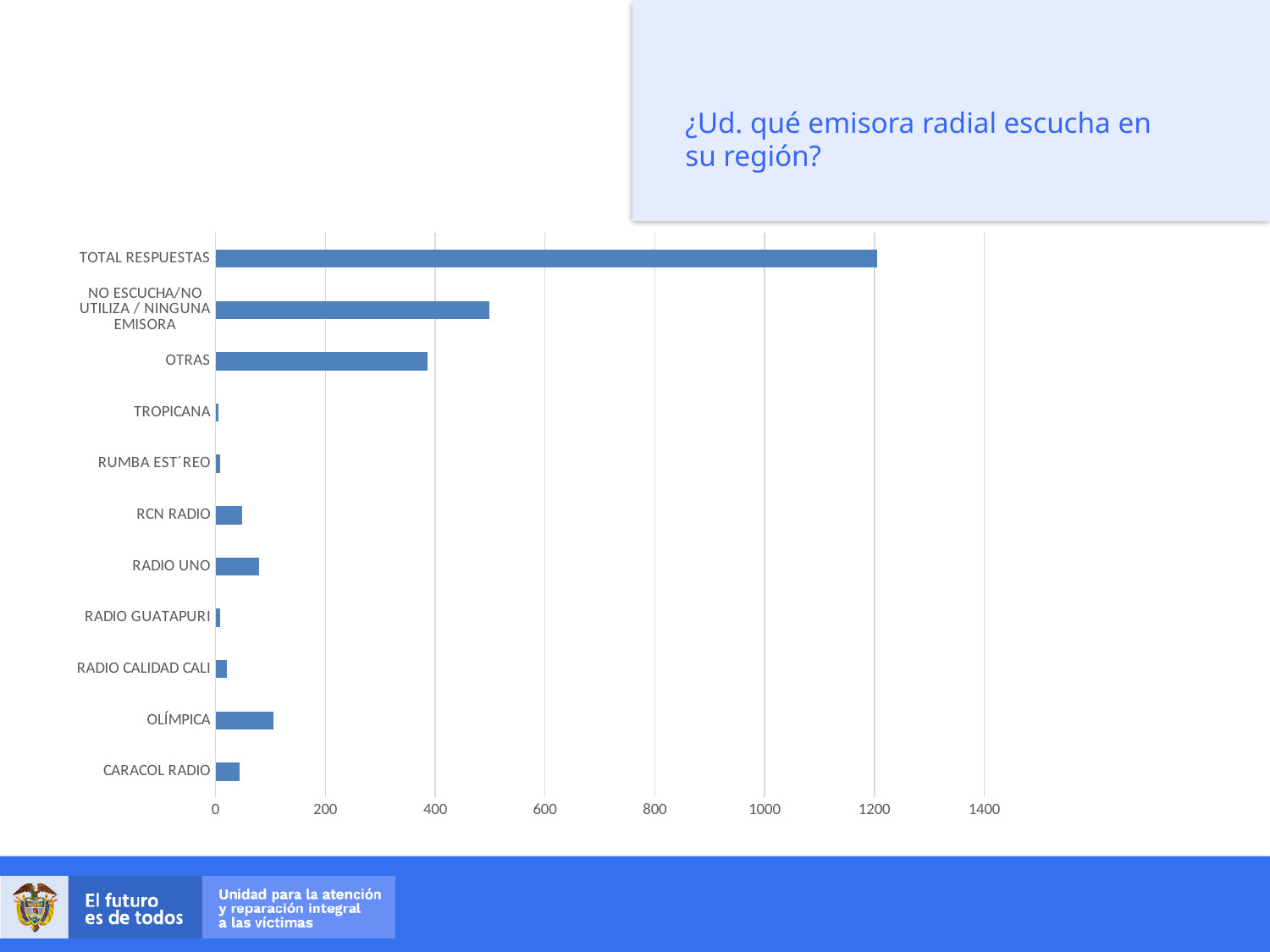
What kind of chart is shown on the slide? bar chart Which is larger, the value for OLÍMPICA or the value for CARACOL RADIO? OLÍMPICA Is the value for RADIO UNO greater or less than 200? less Is the value for OLÍMPICA greater or less than 200? less What question does the slide title ask? ¿Ud. qué emisora radial escucha en su región? Is the value for NO ESCUCHA/NO UTILIZA / NINGUNA EMISORA greater or less than 400? greater Which category has the longest bar? TOTAL RESPUESTAS Which is larger, the value for NO ESCUCHA/NO UTILIZA / NINGUNA EMISORA or the value for OTRAS? NO ESCUCHA/NO UTILIZA / NINGUNA EMISORA How many categories are plotted on the chart? 11 Which is larger, the value for RADIO UNO or the value for RCN RADIO? RADIO UNO